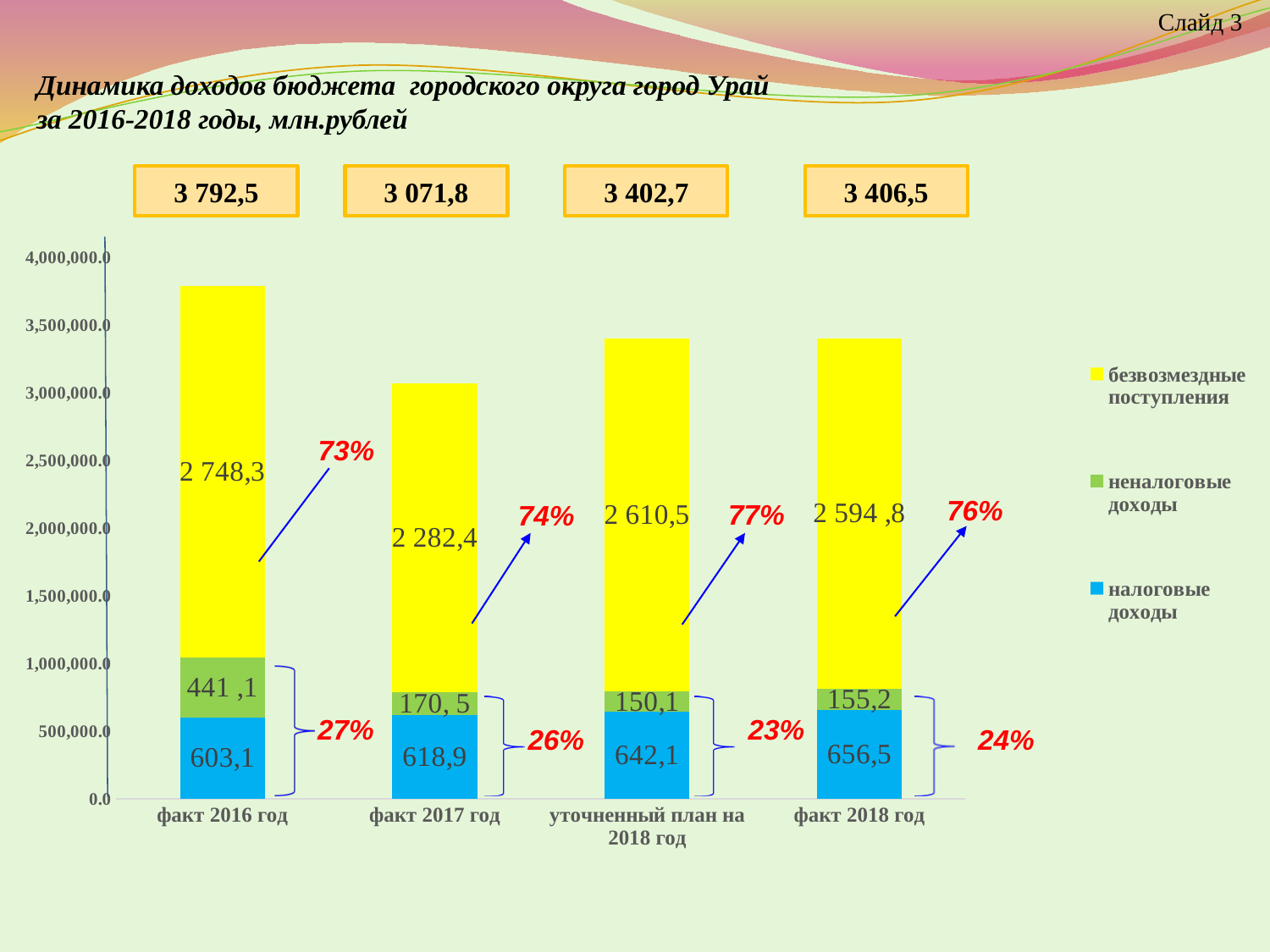
Which category has the highest total budget income? факт 2016 год What is the value of налоговые доходы for факт 2016 год? 603,1 Which category has the lowest value of неналоговые доходы? уточненный план на 2018 год What is the value of безвозмездные поступления for уточненный план на 2018 год? 2 610,5 What is the value of неналоговые доходы for факт 2017 год? 170, 5 Which is larger: безвозмездные поступления for факт 2017 год or for факт 2018 год? факт 2018 год How many series does the legend list? 3 What is the difference between налоговые доходы for факт 2018 год and факт 2016 год? 53,4 What kind of chart is shown on the slide? stacked bar chart Do the values of налоговые доходы rise or fall from факт 2016 год to факт 2018 год? rise How many categories are shown on the x axis? 4 What is the total of the stacked bar for факт 2017 год? 3 071,8